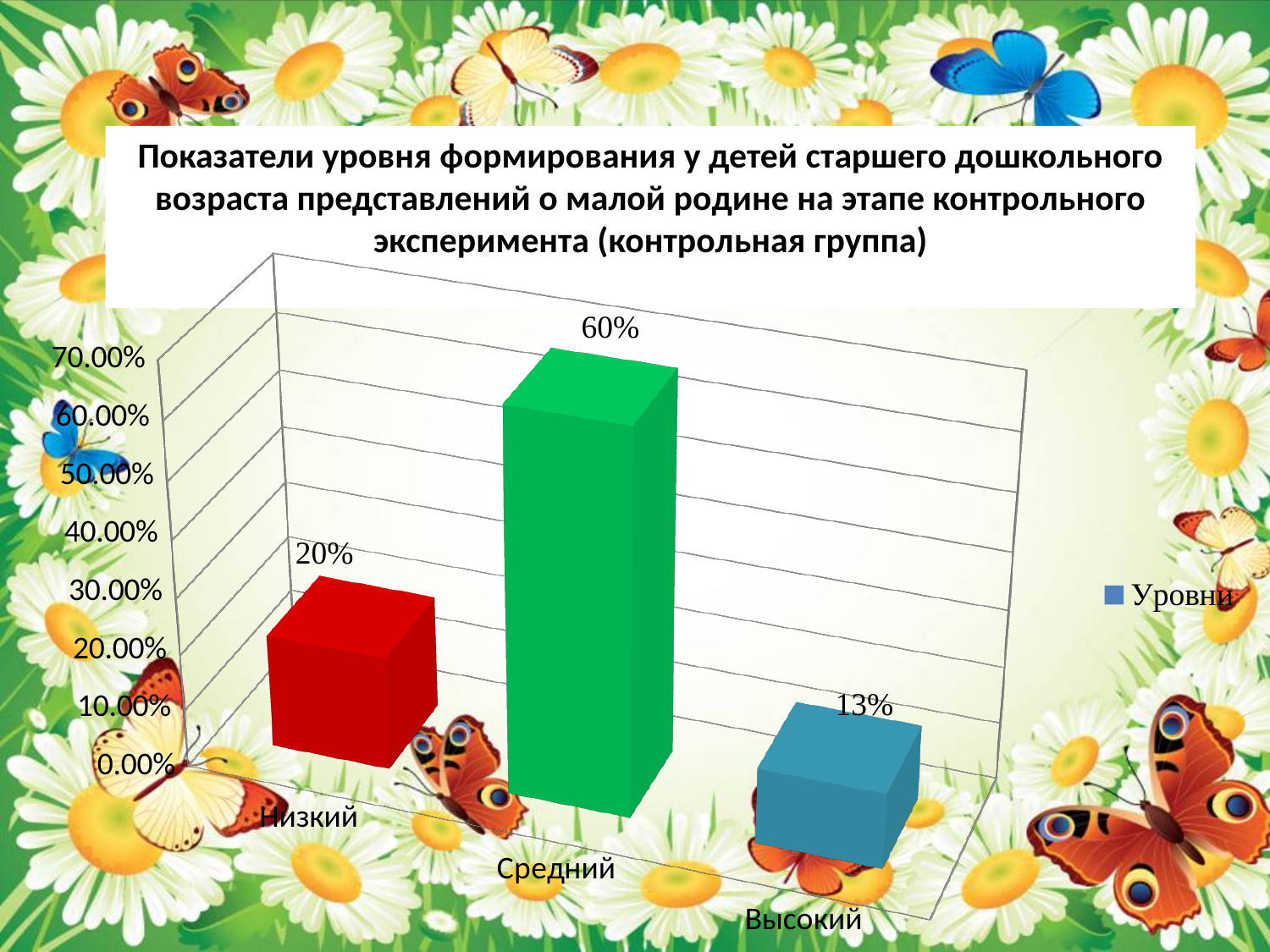
Which is larger, the value for Низкий or the value for Высокий? Низкий Which category has the lowest value? Высокий Is the value for Средний greater or less than 50.00%? greater What kind of chart is shown on the slide? bar chart Which category has the highest value? Средний What is the value for Высокий? 13% How many categories are shown on the x axis? 3 What is the difference between the values for Средний and Низкий? 40% How many series does the legend list? 1 What is the value for Средний? 60% What is the value for Низкий? 20% What is the difference between the values for Низкий and Высокий? 7%